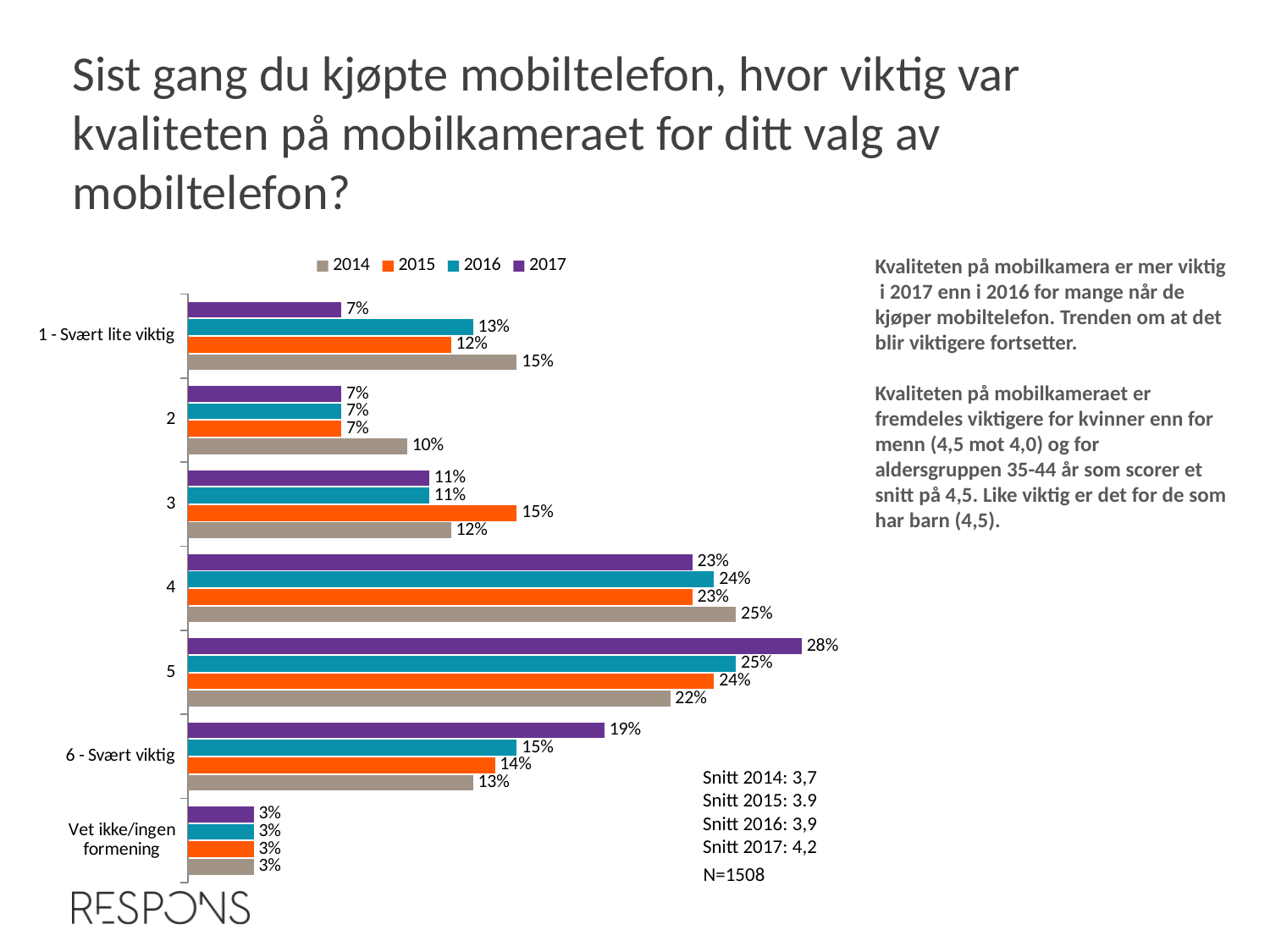
Which category has the lowest value for the 2014 series? Vet ikke/ingen formening What is the difference between the 2017 and 2014 values in the category '6 - Svært viktig'? 6% How many categories are shown on the chart? 7 What kind of chart is shown on the slide? bar chart How many series does the legend list? 4 What is the difference between the 2017 and 2016 values in the category '5'? 3% Which series is shown in purple in the legend? 2017 Which category has the highest value for the 2017 series? 5 What is the value for 2015 in the category '3'? 15% What is the value for 2014 in the category '1 - Svært lite viktig'? 15% What is the value for 2017 in the category '5'? 28% Which is larger in the category '1 - Svært lite viktig': the 2016 value or the 2017 value? 2016